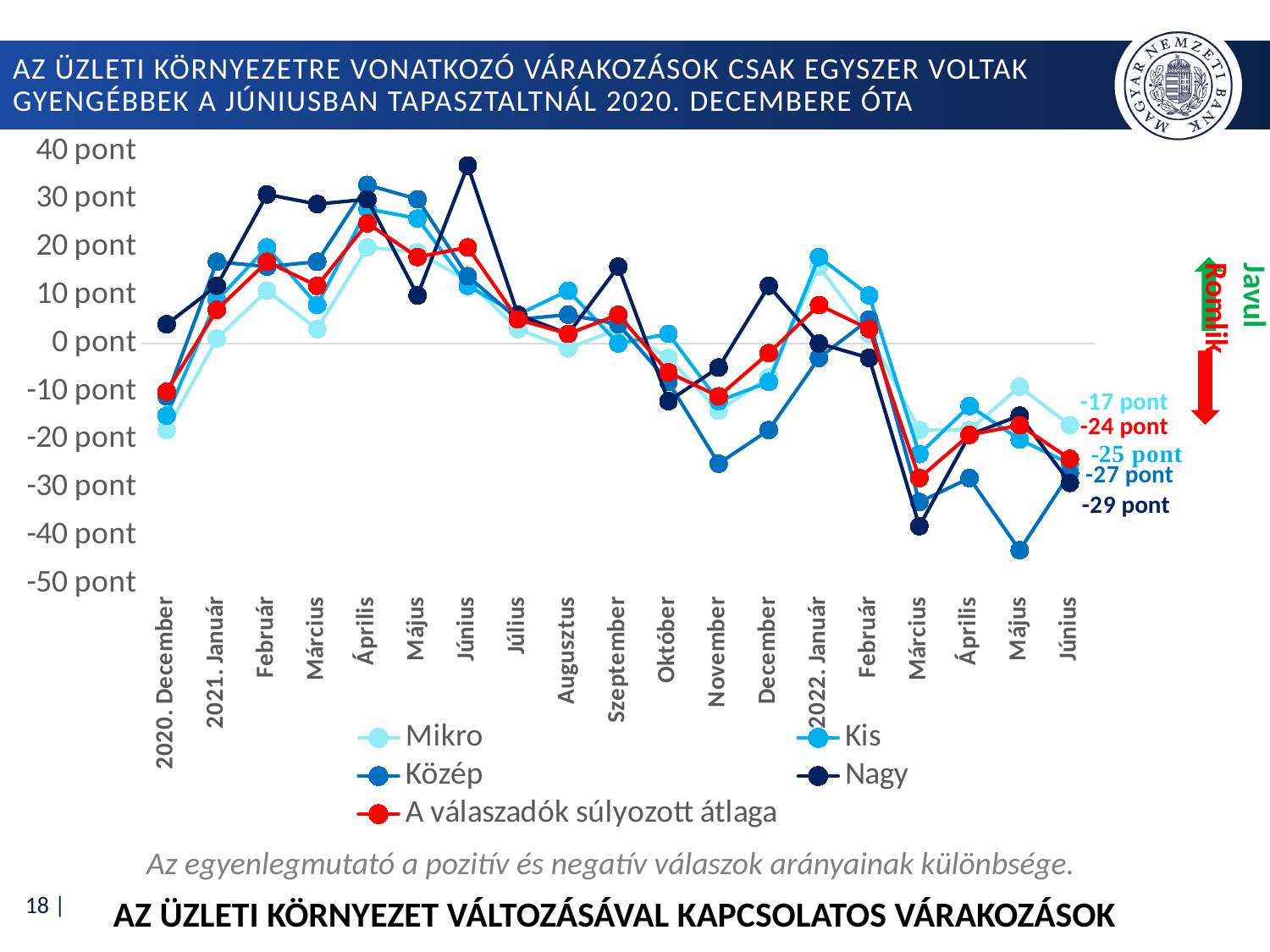
Which series is drawn with the red line? A válaszadók súlyozott átlaga What kind of chart is shown on the slide? Line chart Which series has the highest value in 2022 Június? Mikro Is the value for Nagy in 2021 Június greater or less than 30 pont? greater What is the value of the Mikro series in 2022 Június? -17 pont What is the value of the Nagy series in 2022 Június? -29 pont What is the value of 'A válaszadók súlyozott átlaga' in 2022 Június? -24 pont What is the value of the Kis series in 2022 Június? -25 pont What is the value of the Közép series in 2022 Június? -27 pont How many months (points) are shown along the x axis? 19 What is the difference between the Mikro and Nagy values in 2022 Június? 12 pont How many series does the legend list? 5